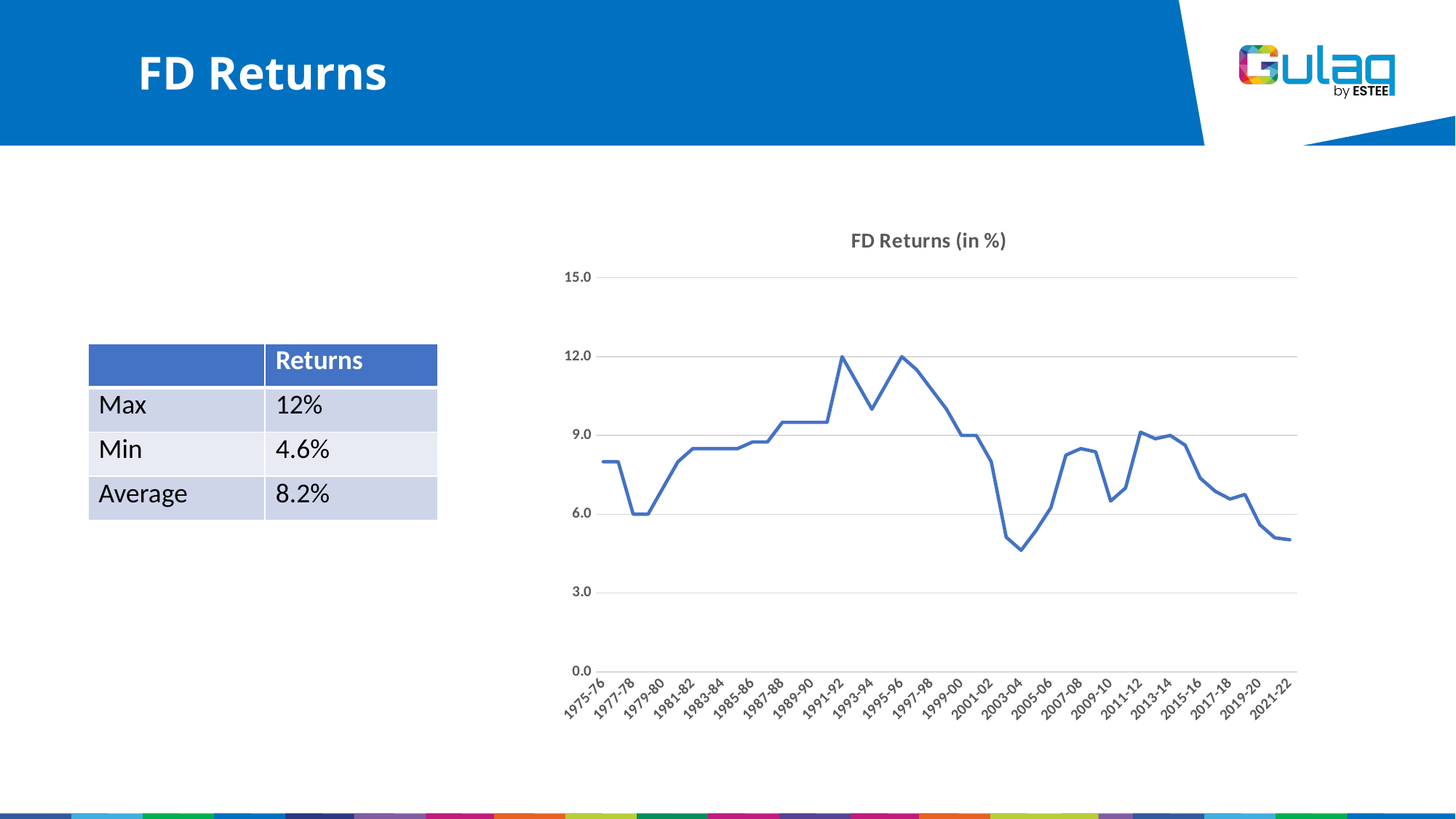
Is the value for 2003-04 greater or less than 6.0? less How many year labels are shown on the x axis? 24 What is the title of the chart? FD Returns (in %) What is the FD return value for 1977-78? 6.0 Which year has the lowest FD return on the chart? 2003-04 Which is larger, the value for 1991-92 or the value for 2003-04? 1991-92 Is the value for 2021-22 greater or less than 6.0? less Which is larger, the value for 1975-76 or the value for 2021-22? 1975-76 Do the values rise or fall from 2013-14 to 2021-22? fall What is the FD return value for 1991-92? 12.0 Is the value for 1975-76 greater or less than 6.0? greater What kind of chart is shown on the slide? line chart